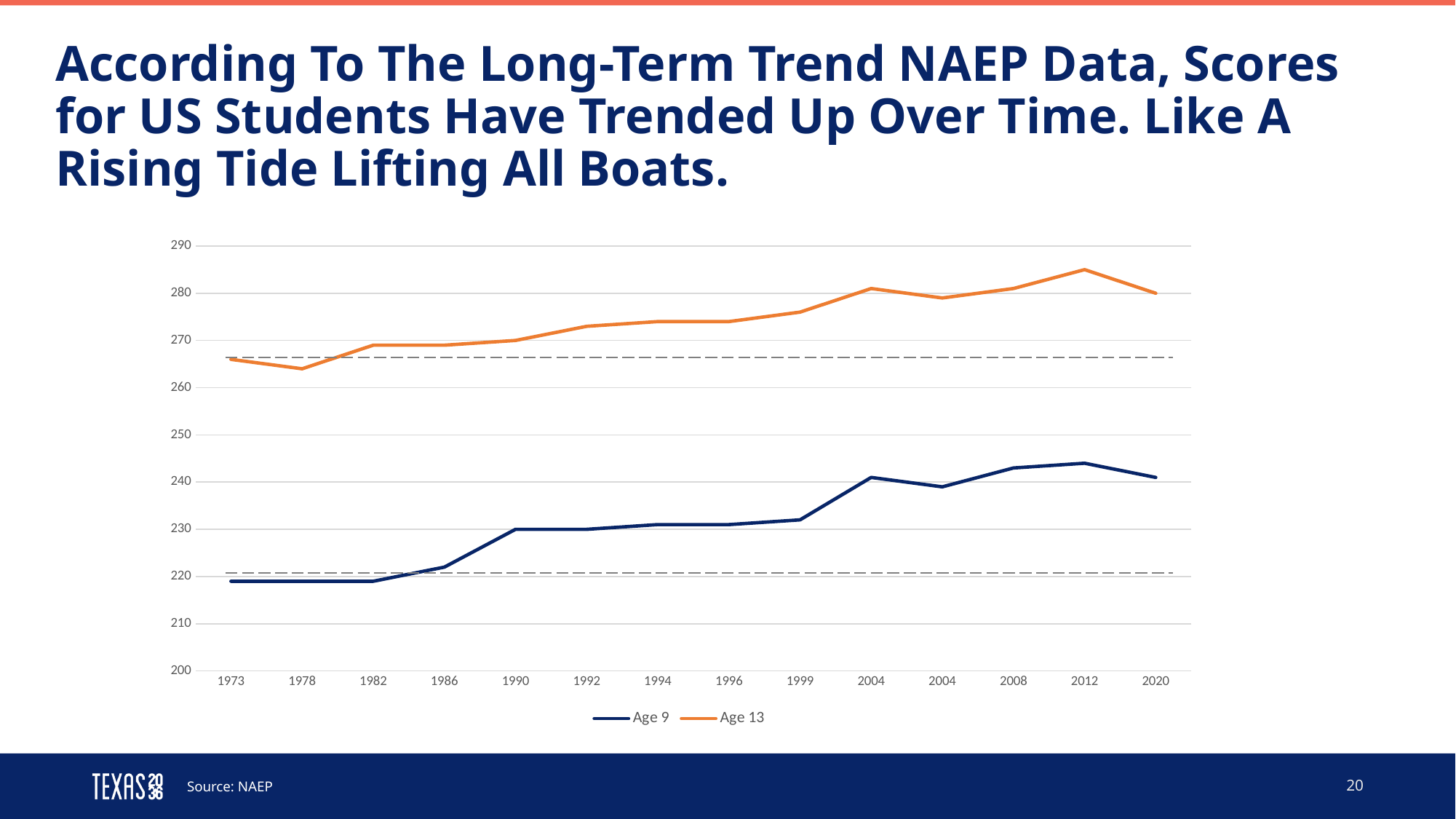
In which year does the Age 13 series reach its lowest value? 1978 Is the Age 9 value for 2012 greater or less than 240? greater In 2020, which series has the higher value, Age 9 or Age 13? Age 13 In which year does the Age 13 series reach its highest value? 2012 What kind of chart is shown on the slide? line chart Is the Age 13 value for 2012 greater or less than 280? greater Is the Age 13 value for 1973 greater or less than 270? less Do the Age 9 scores generally rise or fall from 1973 to 2012? rise How many years are plotted along the x axis? 14 How many series does the legend list? 2 Which series is plotted in orange? Age 13